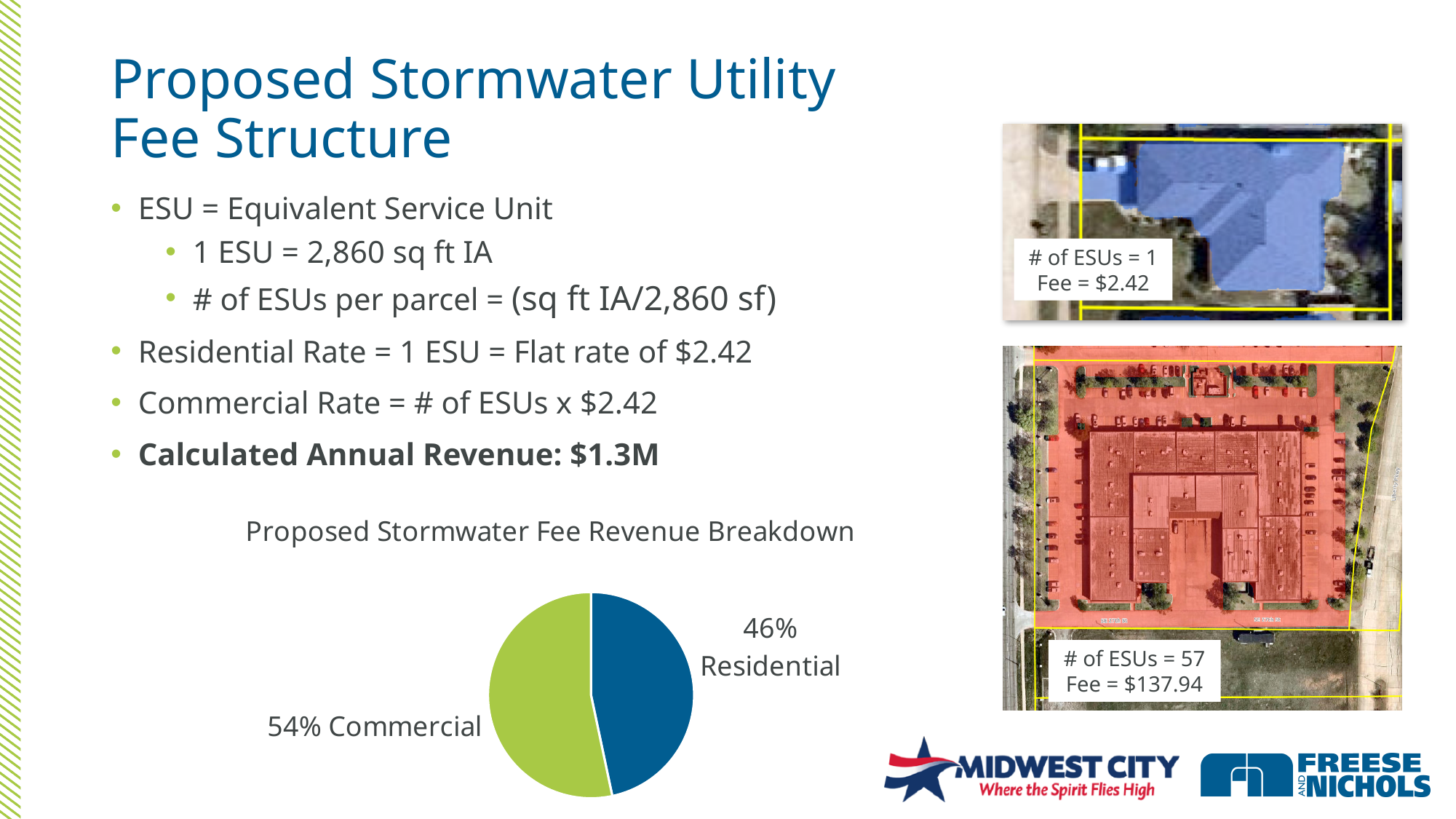
What share of the pie is Commercial? 54% Is the Residential share greater or less than 50%? less What share of the pie is Residential? 46% Which slice of the pie is the smallest? Residential What is the difference in percentage points between the Commercial and Residential shares? 8 Which is larger, the Commercial share or the Residential share? Commercial Which slice of the pie is the largest? Commercial What colour is the Commercial slice of the pie? green How many slices does the pie chart have? 2 What kind of chart is shown on the slide? pie chart What is the title of the chart? Proposed Stormwater Fee Revenue Breakdown